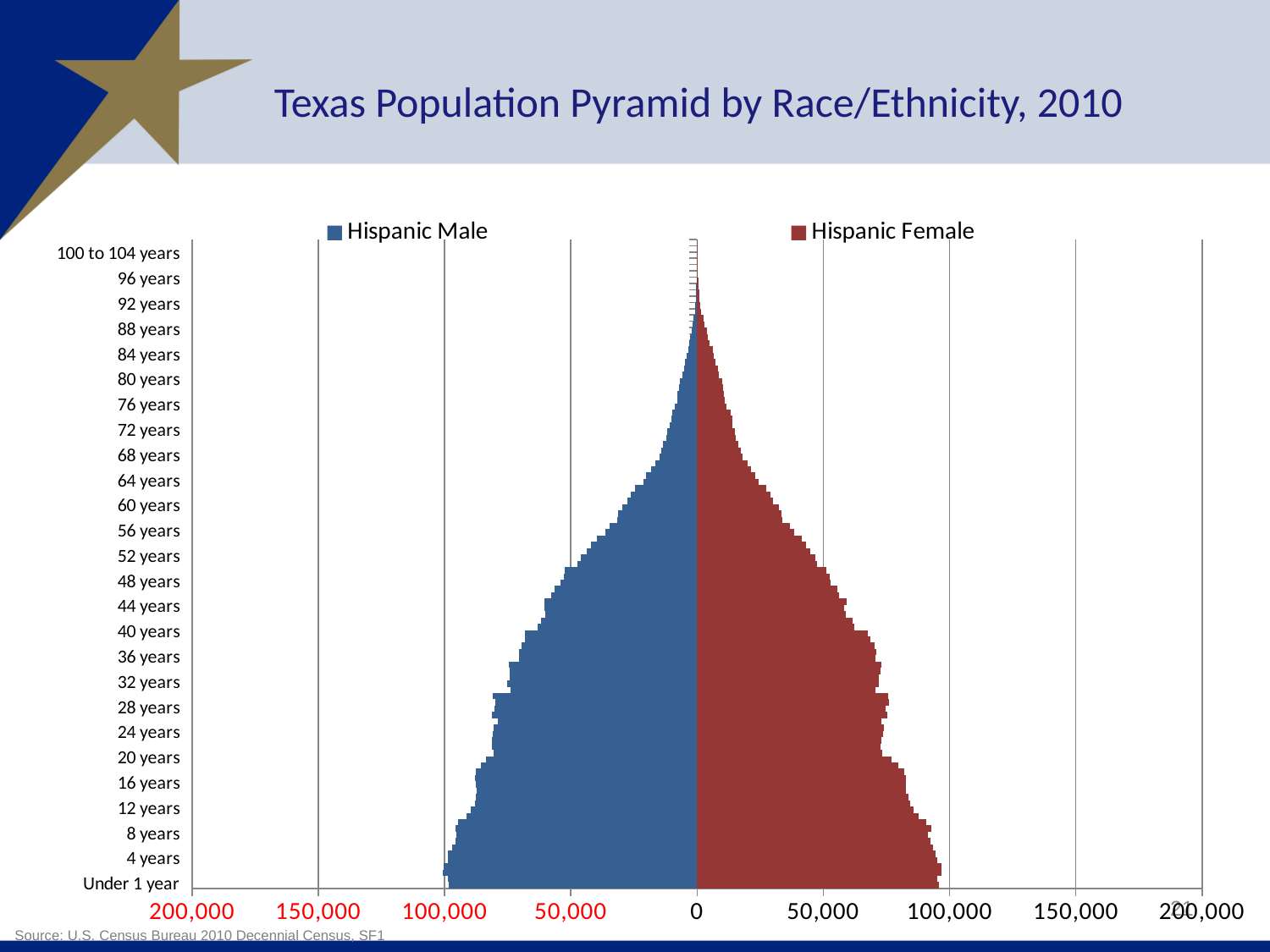
How many series does the legend list? 2 Which is larger for Hispanic Female: the value for 4 years or the value for 60 years? 4 years Do the Hispanic Male values generally rise or fall as age increases from Under 1 year to 100 to 104 years? fall Is the Hispanic Male value for 4 years greater or less than 50,000? greater Is the Hispanic Female value for 36 years greater or less than 50,000? greater What is the title of the chart? Texas Population Pyramid by Race/Ethnicity, 2010 Is the Hispanic Male value for 80 years greater or less than 50,000? less Which series is shown in red? Hispanic Female What kind of chart is shown on the slide? bar chart